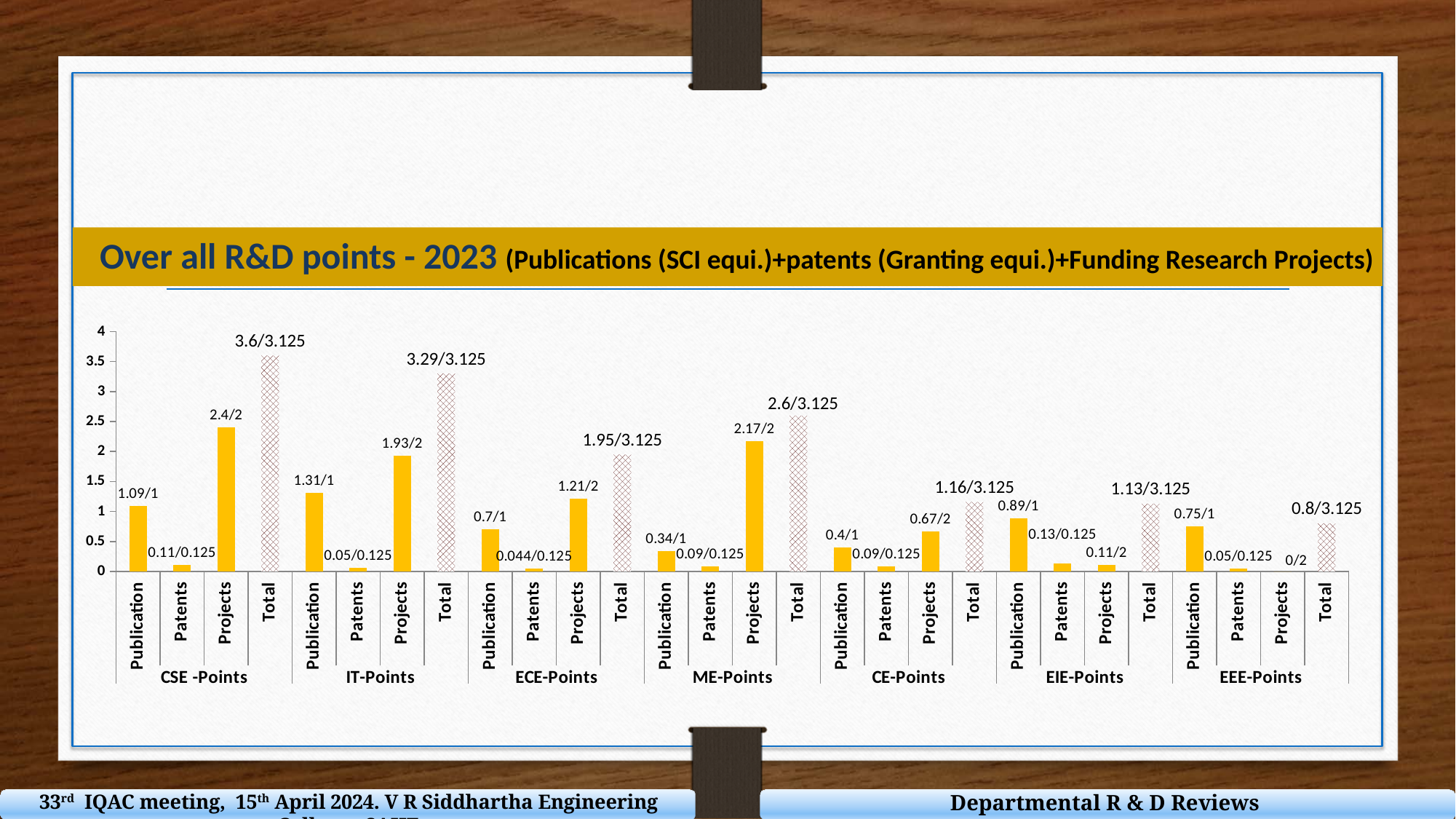
Which department has the lowest Total bar? EEE-Points What is the data label on the Total bar for CSE-Points? 3.6/3.125 Which is larger, the Projects bar for CSE-Points or the Projects bar for IT-Points? CSE-Points What kind of chart is shown on the slide? bar chart What is the data label on the Projects bar for EEE-Points? 0/2 What is the data label on the Patents bar for CE-Points? 0.09/0.125 Is the Total bar for ECE-Points greater or less than 2? less How many departments are shown along the x axis? 7 Which department has the highest Total bar? CSE-Points What is the data label on the Publication bar for IT-Points? 1.31/1 What is the data label on the Projects bar for ME-Points? 2.17/2 Which department has the highest Publication bar? IT-Points